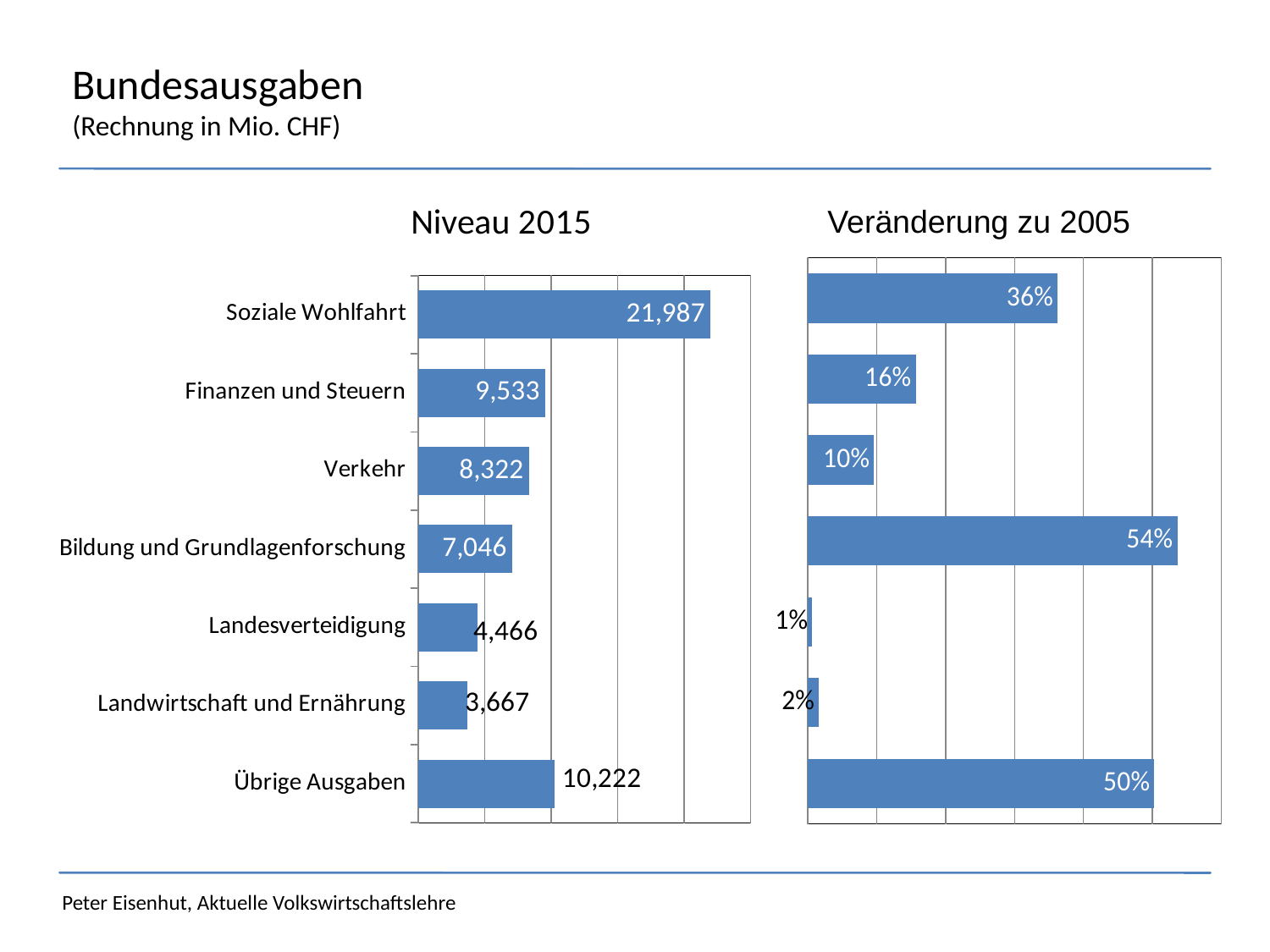
In the 'Niveau 2015' chart, which category has the highest value? Soziale Wohlfahrt In the 'Veränderung zu 2005' chart, what is the value for Bildung und Grundlagenforschung? 54% In the 'Veränderung zu 2005' chart, which category has the lowest value? Landesverteidigung In the 'Niveau 2015' chart, what is the value for Verkehr? 8,322 What type of chart is the 'Veränderung zu 2005' chart? Bar chart In the 'Veränderung zu 2005' chart, which is larger: Soziale Wohlfahrt or Übrige Ausgaben? Übrige Ausgaben In the 'Niveau 2015' chart, which category has the lowest value? Landwirtschaft und Ernährung How many categories are shown in the 'Niveau 2015' chart? 7 In the 'Niveau 2015' chart, what is the difference between Finanzen und Steuern and Verkehr? 1,211 In the 'Veränderung zu 2005' chart, what is the value for Landesverteidigung? 1% In the 'Veränderung zu 2005' chart, which category has the highest value? Bildung und Grundlagenforschung In the 'Niveau 2015' chart, what is the value for Soziale Wohlfahrt? 21,987